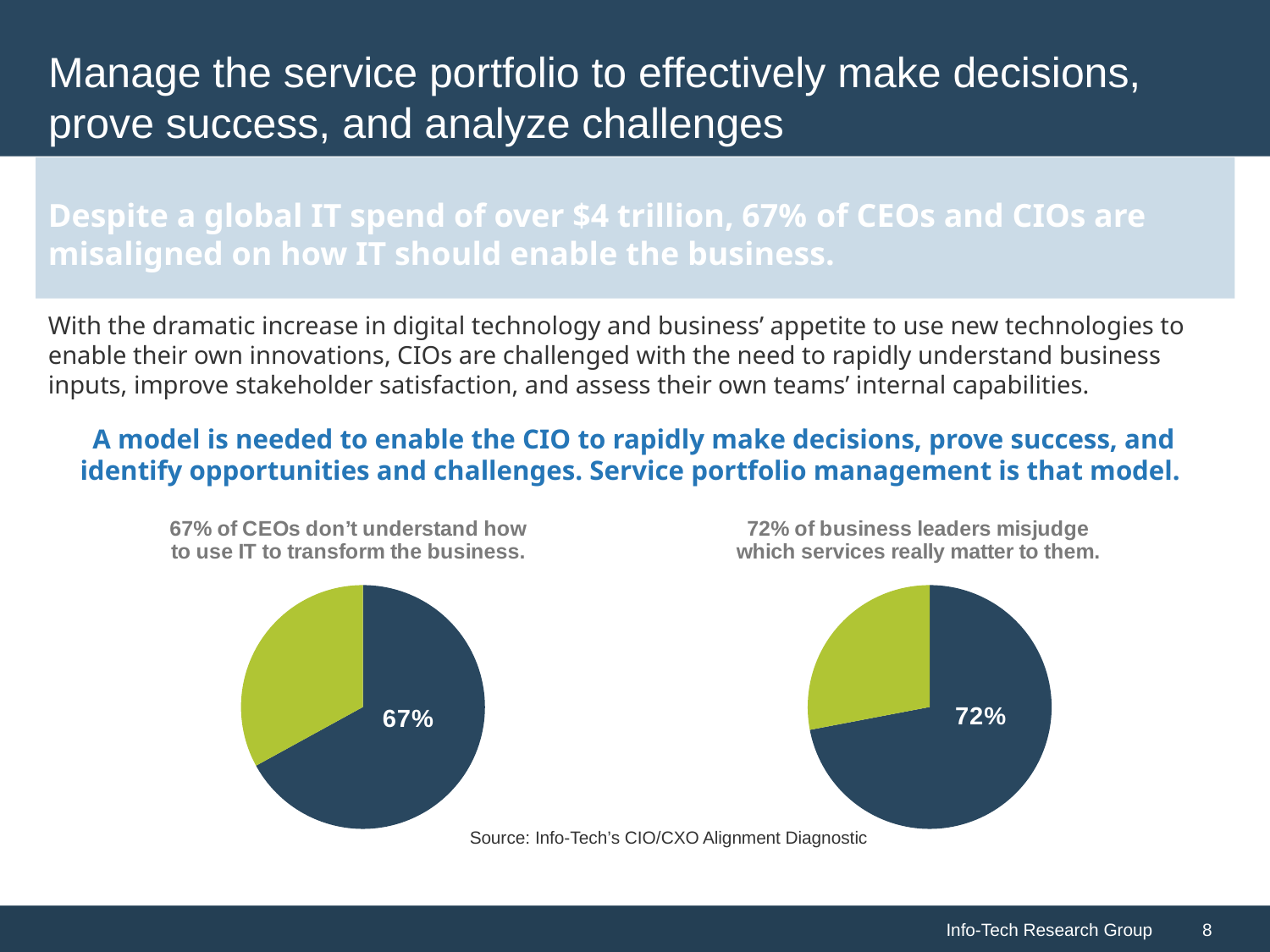
What kind of chart is the right chart on the slide? pie chart What is the difference between the labelled slice of the right pie chart and the labelled slice of the left pie chart? 5% Which chart shows the larger labelled slice, the left pie chart (67%) or the right pie chart (72%)? the right pie chart How many slices does the right pie chart have? 2 What is the caption above the left pie chart? 67% of CEOs don't understand how to use IT to transform the business. What is the caption above the right pie chart? 72% of business leaders misjudge which services really matter to them. In the right pie chart, which slice is larger, the dark blue slice or the green slice? the dark blue slice In the left pie chart, what percentage is printed on the dark blue slice? 67% What kind of chart is the left chart on the slide? pie chart In the right pie chart, what percentage is printed on the dark blue slice? 72% In the left pie chart, which slice is larger, the dark blue slice or the green slice? the dark blue slice How many slices does the left pie chart have? 2